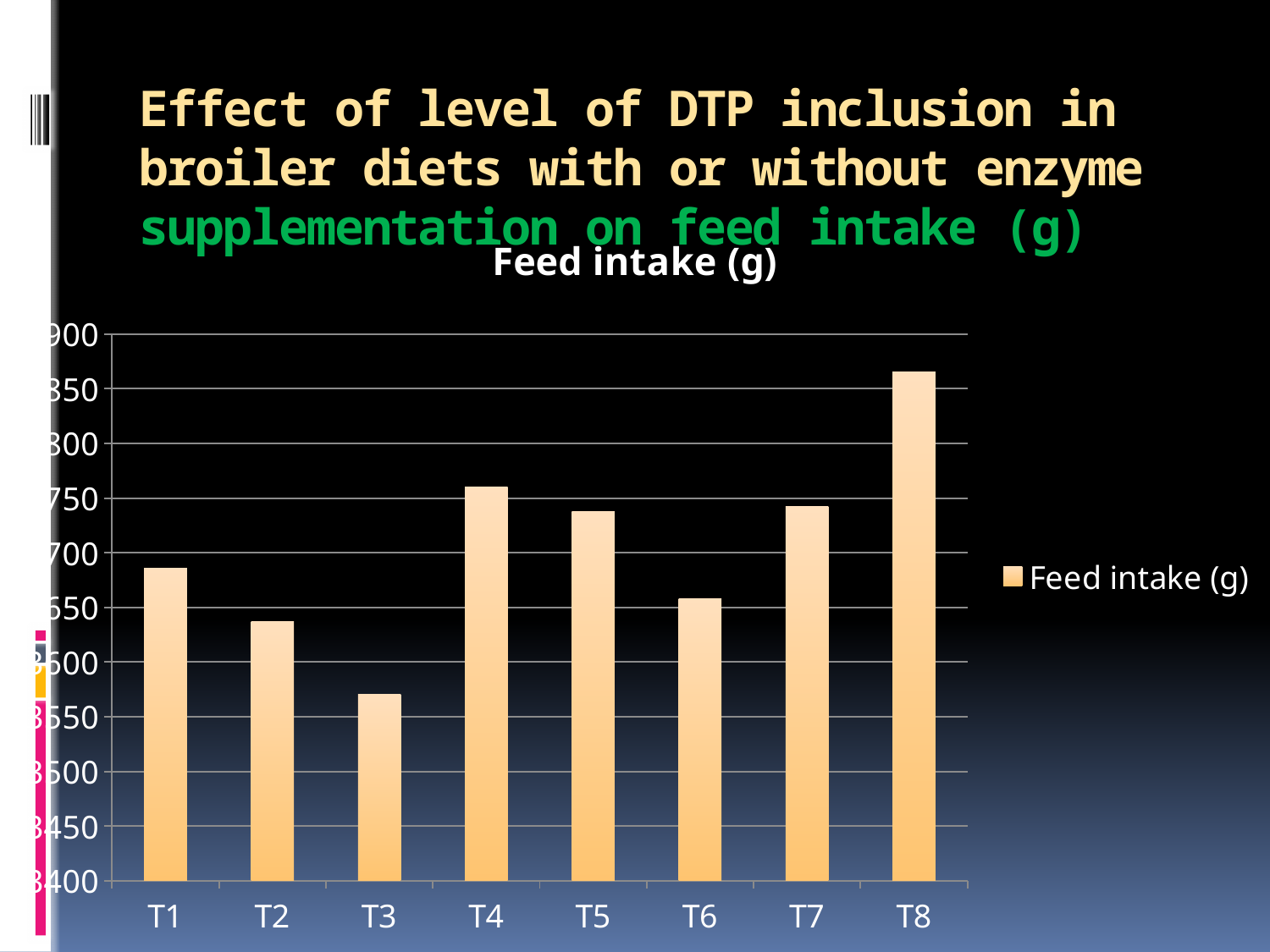
Which has the larger feed intake, T1 or T3? T1 Which treatment has the highest feed intake in the chart? T8 Which has the larger feed intake, T4 or T6? T4 Which treatment has the lowest feed intake in the chart? T3 What kind of chart is shown on the slide? Bar chart Is the feed intake for T8 greater or less than 3800? greater Is the feed intake for T3 greater or less than 3600? less Which has the larger feed intake, T8 or T1? T8 How many categories (treatments) are plotted on the x axis of the chart? 8 Is the feed intake for T5 greater or less than 3700? greater What is the title of the chart? Feed intake (g) How many series does the chart's legend list? 1